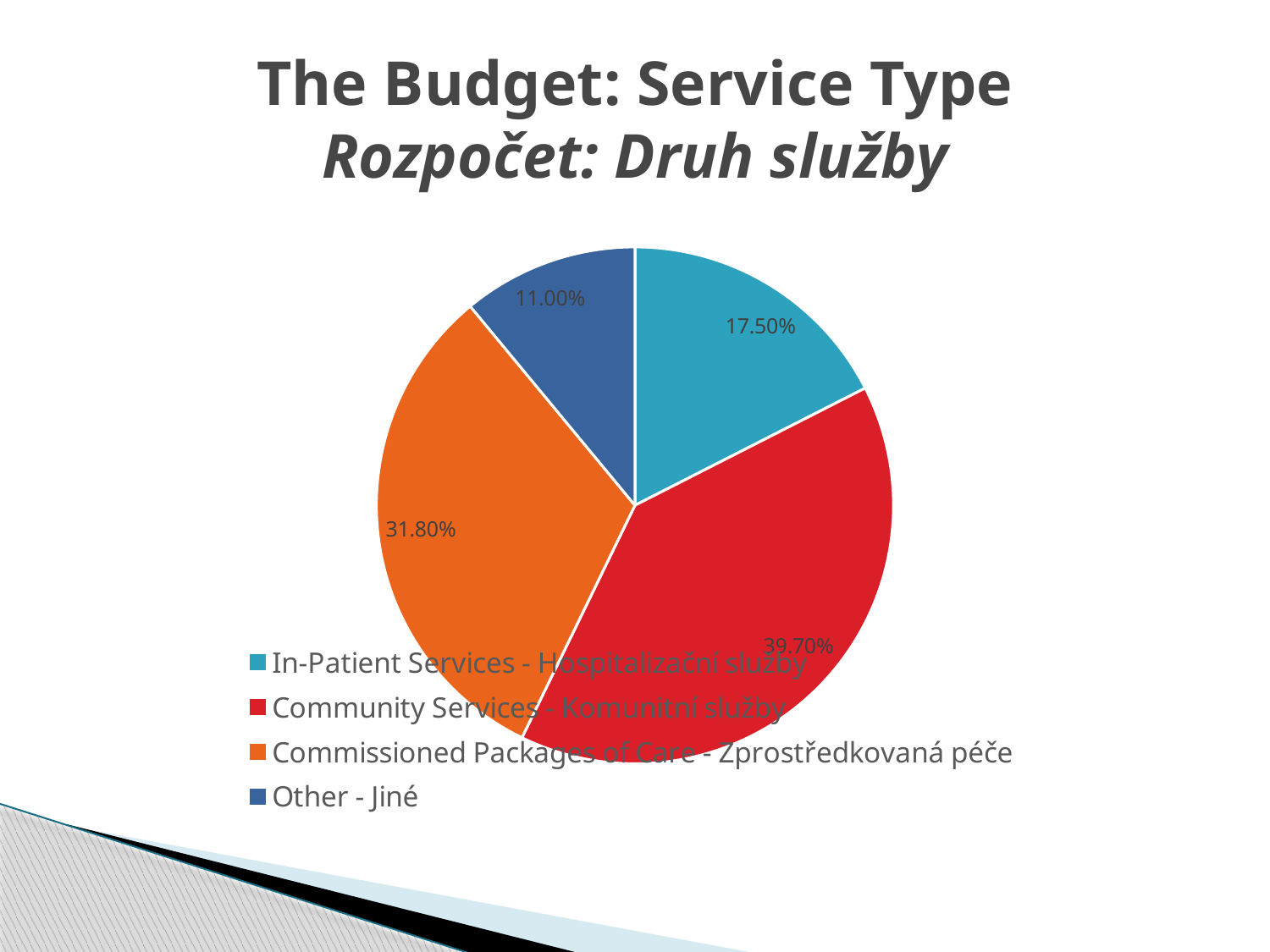
What colour represents Commissioned Packages of Care in the chart? Orange What percentage of the budget goes to Commissioned Packages of Care? 31.80% What is the difference in percentage points between Community Services and Commissioned Packages of Care? 7.90 What percentage of the budget goes to Other? 11.00% What percentage of the budget goes to Community Services? 39.70% Which service type has the largest share of the budget? Community Services How many service types are shown in the pie chart? 4 What is the combined share of In-Patient Services and Other? 28.50% Which is larger, the share for In-Patient Services or the share for Other? In-Patient Services Which service type has the smallest share of the budget? Other What percentage of the budget goes to In-Patient Services? 17.50% What kind of chart is shown on the slide? Pie chart